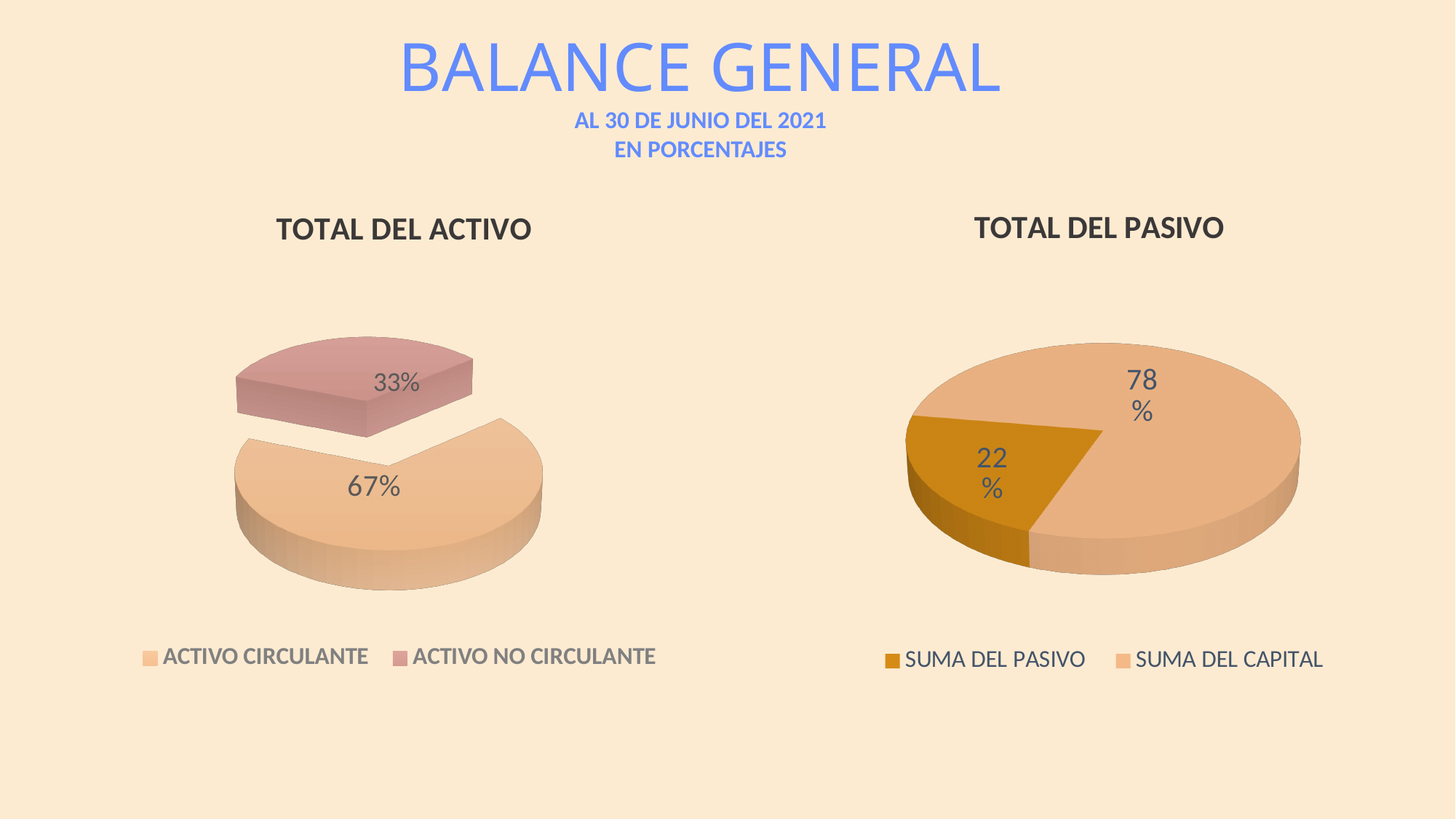
In the TOTAL DEL PASIVO chart, which is larger, SUMA DEL PASIVO or SUMA DEL CAPITAL? SUMA DEL CAPITAL In the TOTAL DEL PASIVO chart, what is the value for SUMA DEL CAPITAL? 78% In the TOTAL DEL PASIVO chart, what is the difference between SUMA DEL CAPITAL and SUMA DEL PASIVO? 56% In the TOTAL DEL ACTIVO chart, what is the difference between ACTIVO CIRCULANTE and ACTIVO NO CIRCULANTE? 34% In the TOTAL DEL ACTIVO chart, which category has the largest slice? ACTIVO CIRCULANTE What kind of chart is the TOTAL DEL ACTIVO chart? Pie chart In the TOTAL DEL ACTIVO chart, what is the value for ACTIVO CIRCULANTE? 67% In the TOTAL DEL ACTIVO chart, what is the value for ACTIVO NO CIRCULANTE? 33% How many slices does the TOTAL DEL PASIVO chart have? 2 In the TOTAL DEL PASIVO chart, which category has the smallest slice? SUMA DEL PASIVO In the TOTAL DEL PASIVO chart, what is the value for SUMA DEL PASIVO? 22% What are the legend entries of the TOTAL DEL ACTIVO chart? ACTIVO CIRCULANTE, ACTIVO NO CIRCULANTE